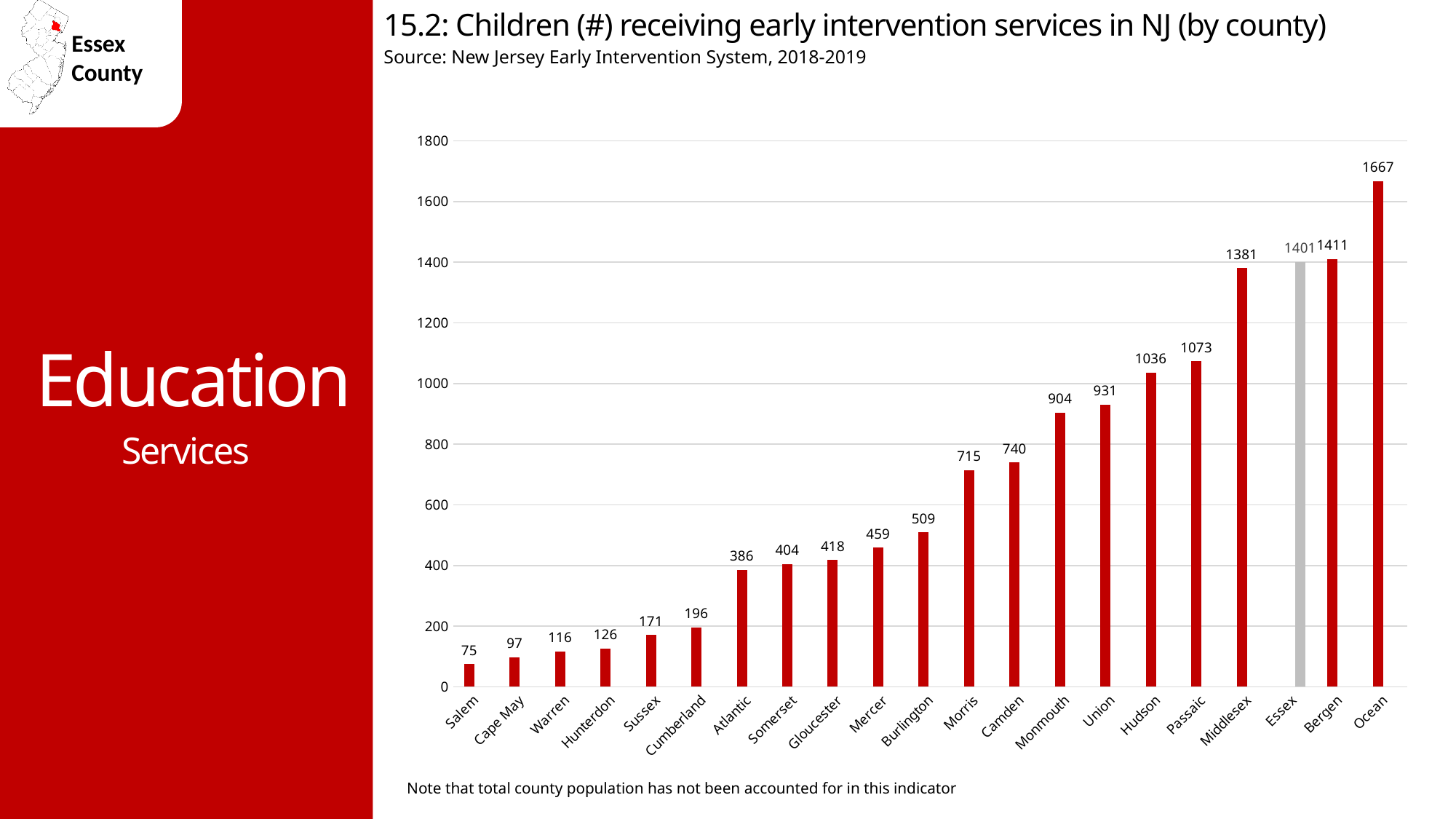
What is the value for Hudson? 1036 What is the value for Salem? 75 What is the value for Essex? 1401 Which county's bar is coloured grey instead of red? Essex Is the value for Passaic greater or less than 1000? greater What kind of chart is this? bar chart Which county has the highest value? Ocean Which county has the lowest value? Salem Do the values rise or fall from left to right along the x axis? rise What is the difference between the values for Ocean and Essex? 266 How many counties are shown on the x axis? 21 Which is larger, the value for Morris or the value for Monmouth? Monmouth